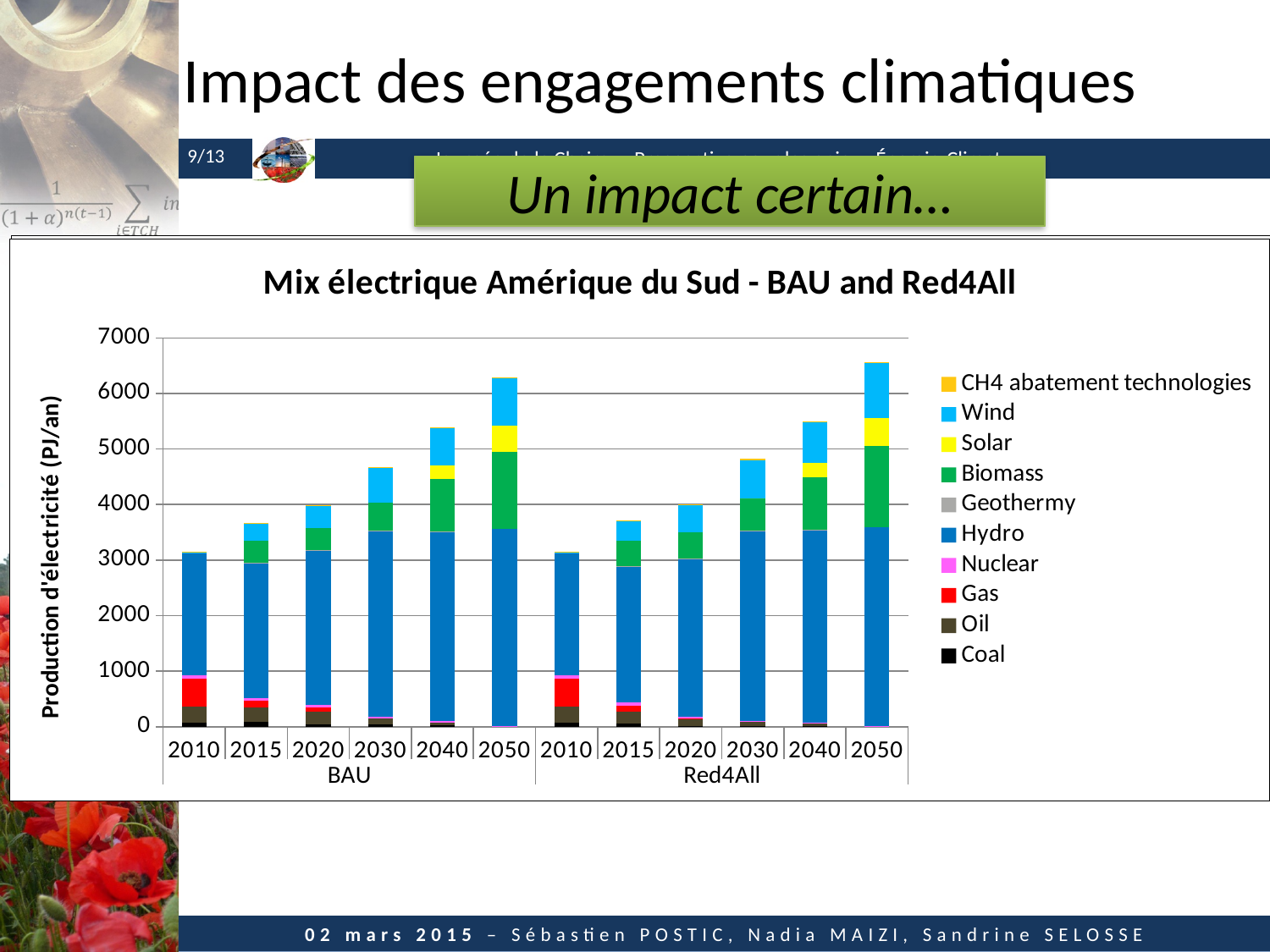
Within the BAU scenario, does total electricity production rise or fall from 2010 to 2050? rise Within the BAU scenario, which year has the lowest total electricity production? 2010 What kind of chart is shown on the slide? Stacked bar chart Is the total for Red4All 2030 greater or less than 5000? less Is the total for BAU 2040 greater or less than 5000? greater What is the label of the vertical axis? Production d'électricité (PJ/an) How many series does the legend list? 10 Which bar has the highest total electricity production? Red4All 2050 Is the total for BAU 2050 greater or less than 6000? greater How many bars are plotted in the chart? 12 What is the title of the chart? Mix électrique Amérique du Sud - BAU and Red4All